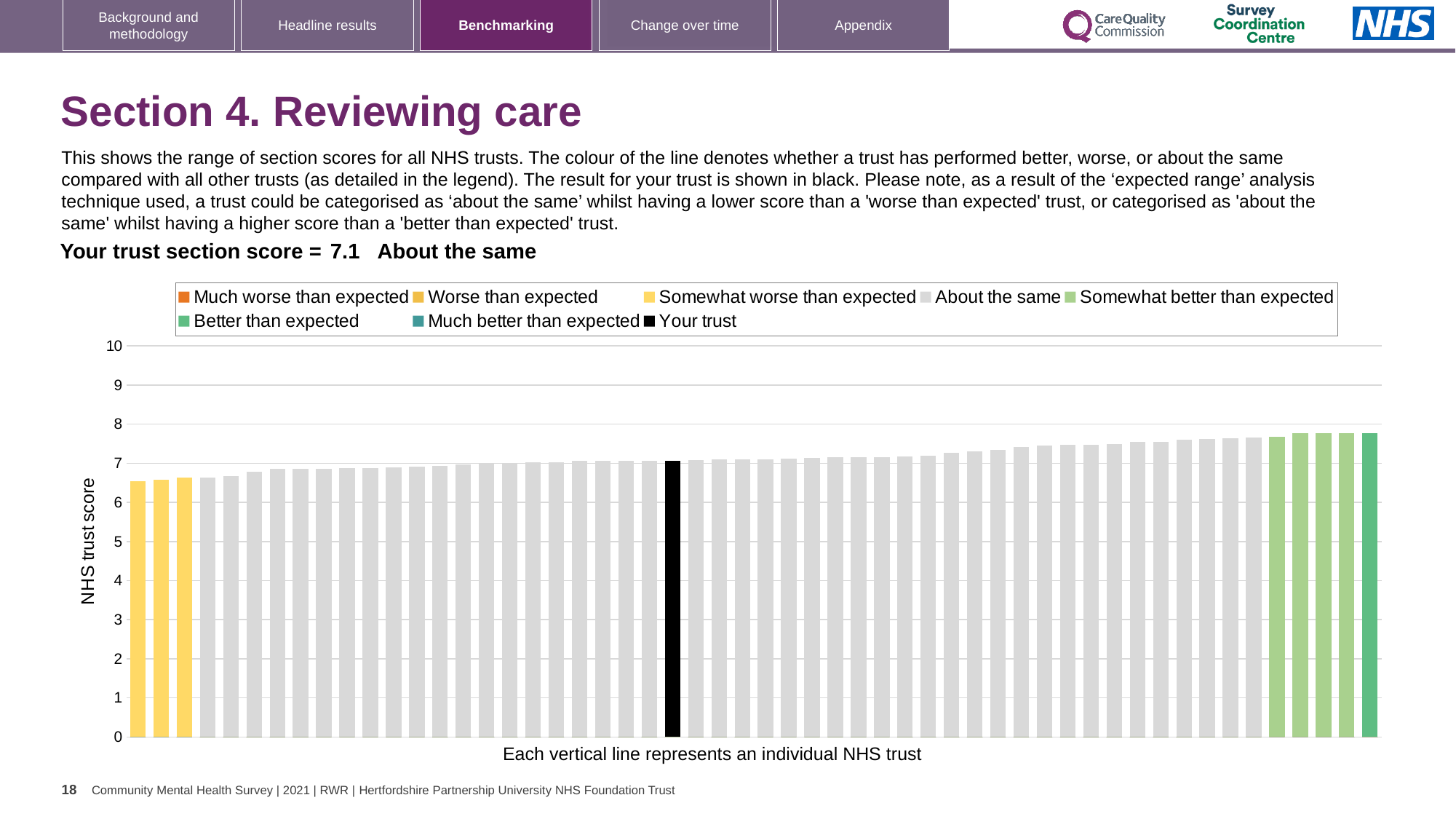
What colour is the bar representing your trust? black Is the lowest trust score on the chart greater or less than 6? greater What kind of chart is shown on the slide? bar chart Which performance category is your trust placed in? About the same How many bars are coloured as 'Somewhat worse than expected' (yellow)? 3 Which legend category does the highest bar on the chart belong to? Better than expected What is the section score for your trust? 7.1 Is the value for your trust greater or less than 5? greater How many entries does the chart legend list? 8 Do the bar values rise or fall from left to right along the x axis? rise Is the highest trust score on the chart greater or less than 8? less Which is larger, the leftmost bar or the rightmost bar? the rightmost bar